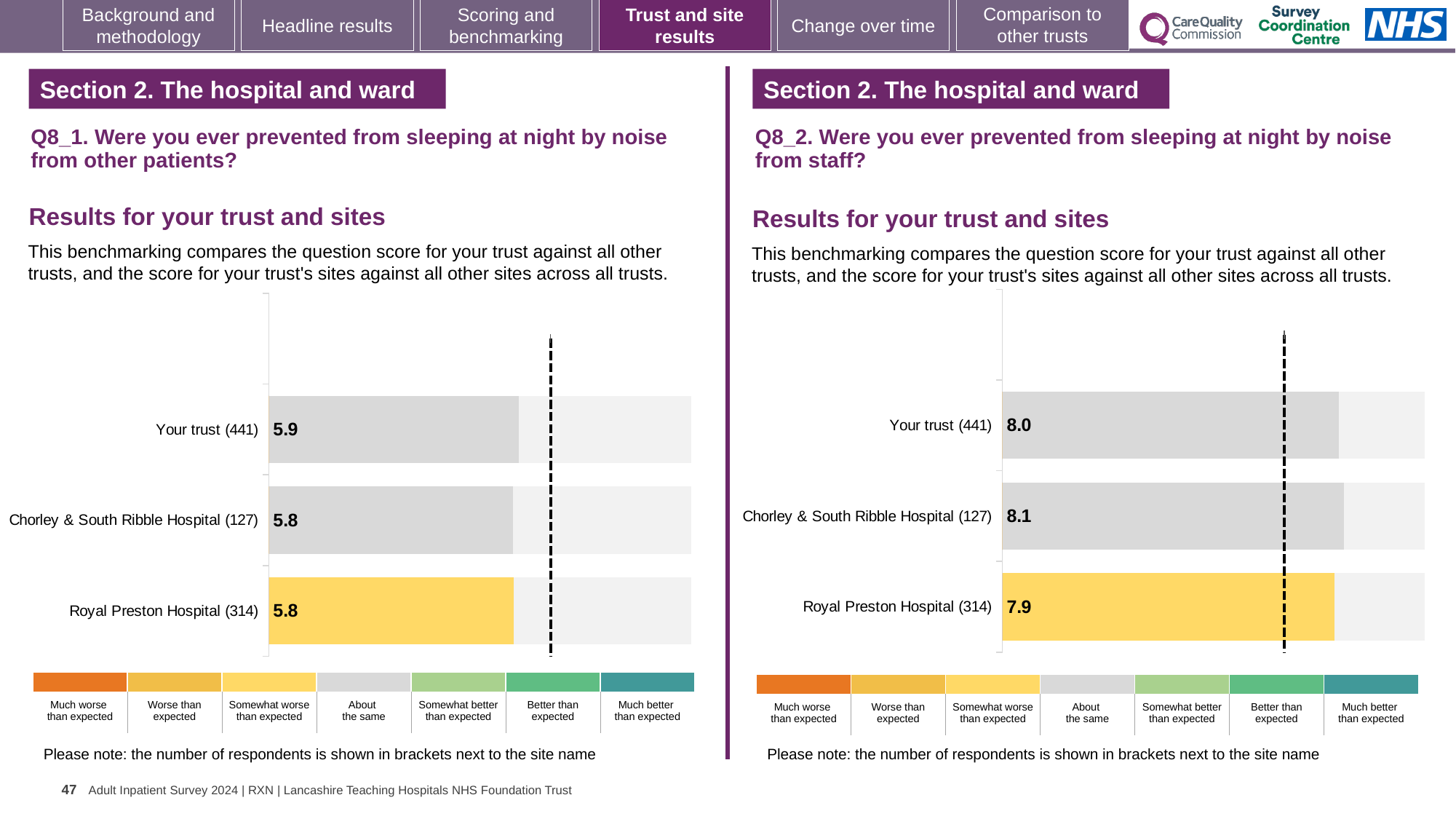
On the Q8_1 chart (left), what is the difference between the scores for Your trust (441) and Chorley & South Ribble Hospital (127)? 0.1 On the Q8_2 chart (right), which site or trust has the highest score? Chorley & South Ribble Hospital (127) What type of chart is used on the Q8_2 chart (right)? Bar chart On the Q8_2 chart (right), which has a higher score: Your trust (441) or Royal Preston Hospital (314)? Your trust (441) On the Q8_2 chart (right), what is the score for Royal Preston Hospital (314)? 7.9 On the Q8_2 chart (right), what is the score for Chorley & South Ribble Hospital (127)? 8.1 How many bars are plotted on the Q8_1 chart (left)? 3 On the Q8_1 chart (left), which has the highest score? Your trust (441) On the Q8_2 chart (right), what is the difference between the scores for Chorley & South Ribble Hospital (127) and Royal Preston Hospital (314)? 0.2 On the Q8_2 chart (right), which site or trust has the lowest score? Royal Preston Hospital (314) On the Q8_1 chart (left), what is the score for Your trust (441)? 5.9 On the Q8_1 chart (left), what is the score for Royal Preston Hospital (314)? 5.8